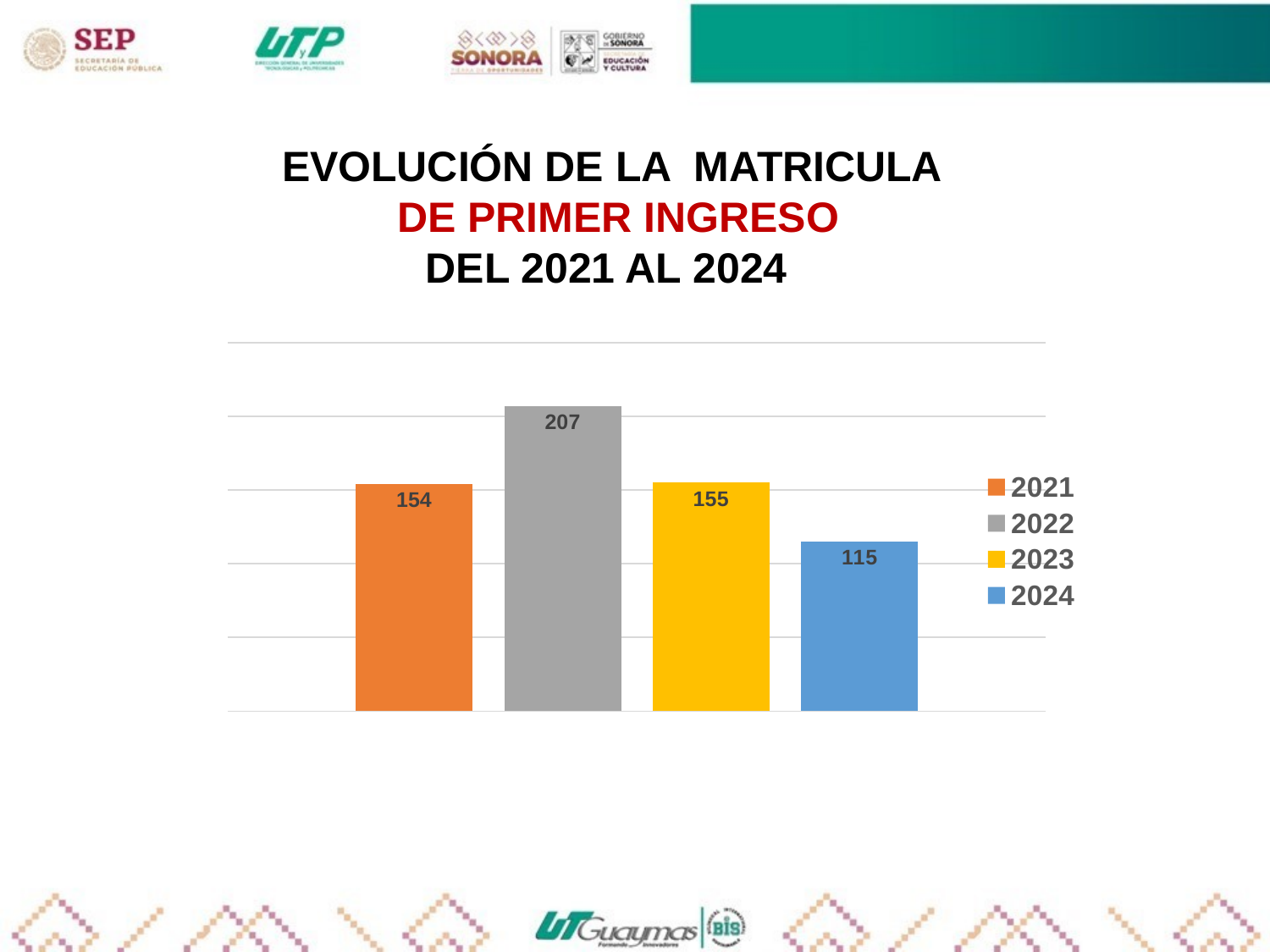
Which is larger, the value for 2022 or the value for 2023? 2022 What is the value for 2024? 115 How many bars are plotted in the chart? 4 What is the difference between the values for 2022 and 2024? 92 Which year has the highest value? 2022 What is the value for 2021? 154 How many entries does the legend list? 4 Which year has the lowest value? 2024 What is the value for 2022? 207 What is the difference between the values for 2022 and 2021? 53 What is the value for 2023? 155 What kind of chart is shown on the slide? Bar chart